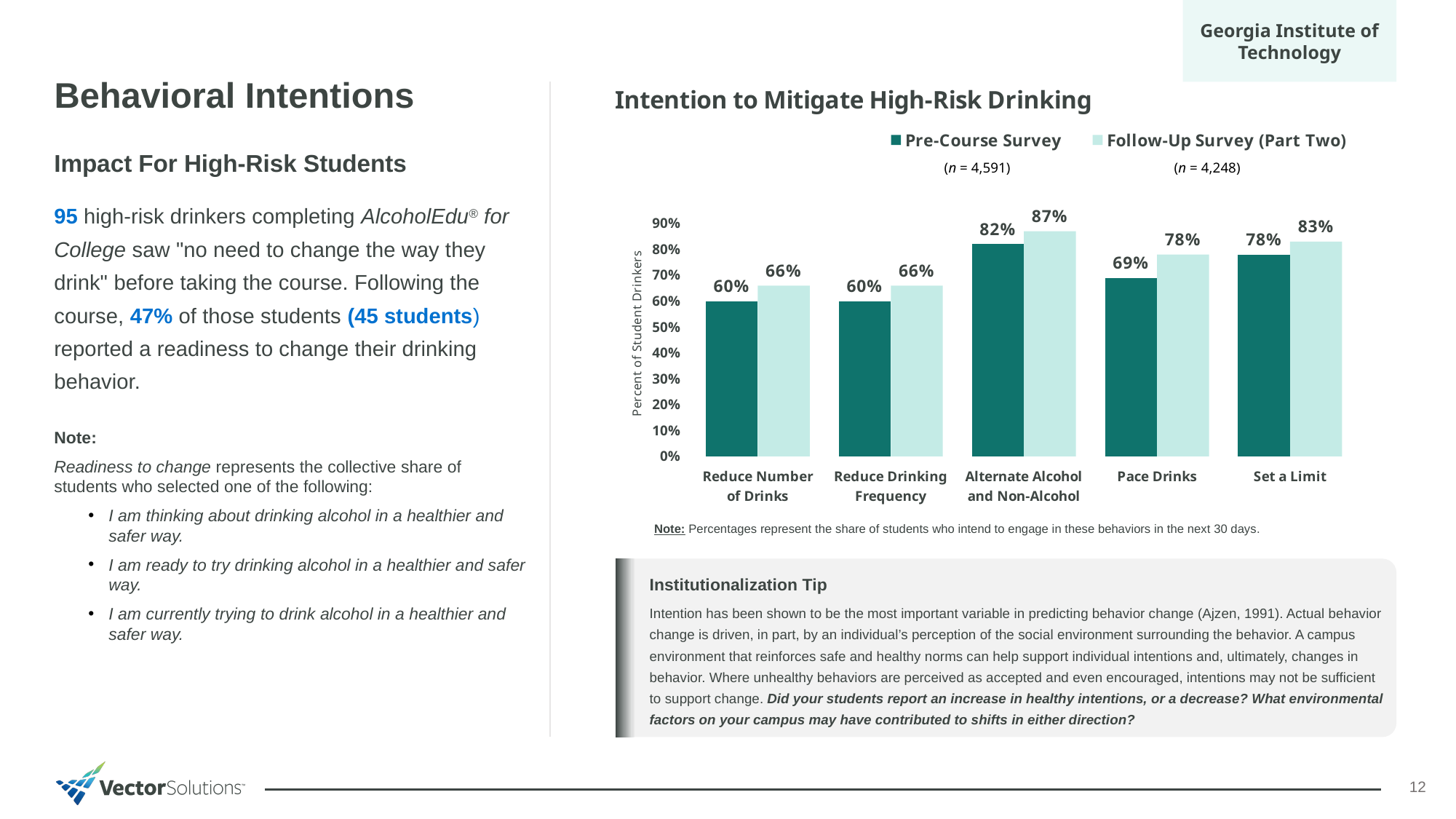
Which category has the lowest Follow-Up Survey (Part Two) value? Reduce Number of Drinks and Reduce Drinking Frequency (both 66%) What is the title of the chart? Intention to Mitigate High-Risk Drinking What is the Follow-Up Survey (Part Two) value for Set a Limit? 83% How many series does the legend list? 2 What kind of chart is shown? Bar chart Which is larger for Set a Limit: the Pre-Course Survey value or the Follow-Up Survey (Part Two) value? Follow-Up Survey (Part Two) How many behavior categories are shown on the x axis? 5 What is the sample size (n) for the Pre-Course Survey shown in the legend? 4,591 What is the Pre-Course Survey value for Pace Drinks? 69% What is the Follow-Up Survey (Part Two) value for Alternate Alcohol and Non-Alcohol? 87% Which category has the highest Pre-Course Survey value? Alternate Alcohol and Non-Alcohol What is the difference between the Follow-Up Survey (Part Two) and Pre-Course Survey values for Pace Drinks? 9 percentage points